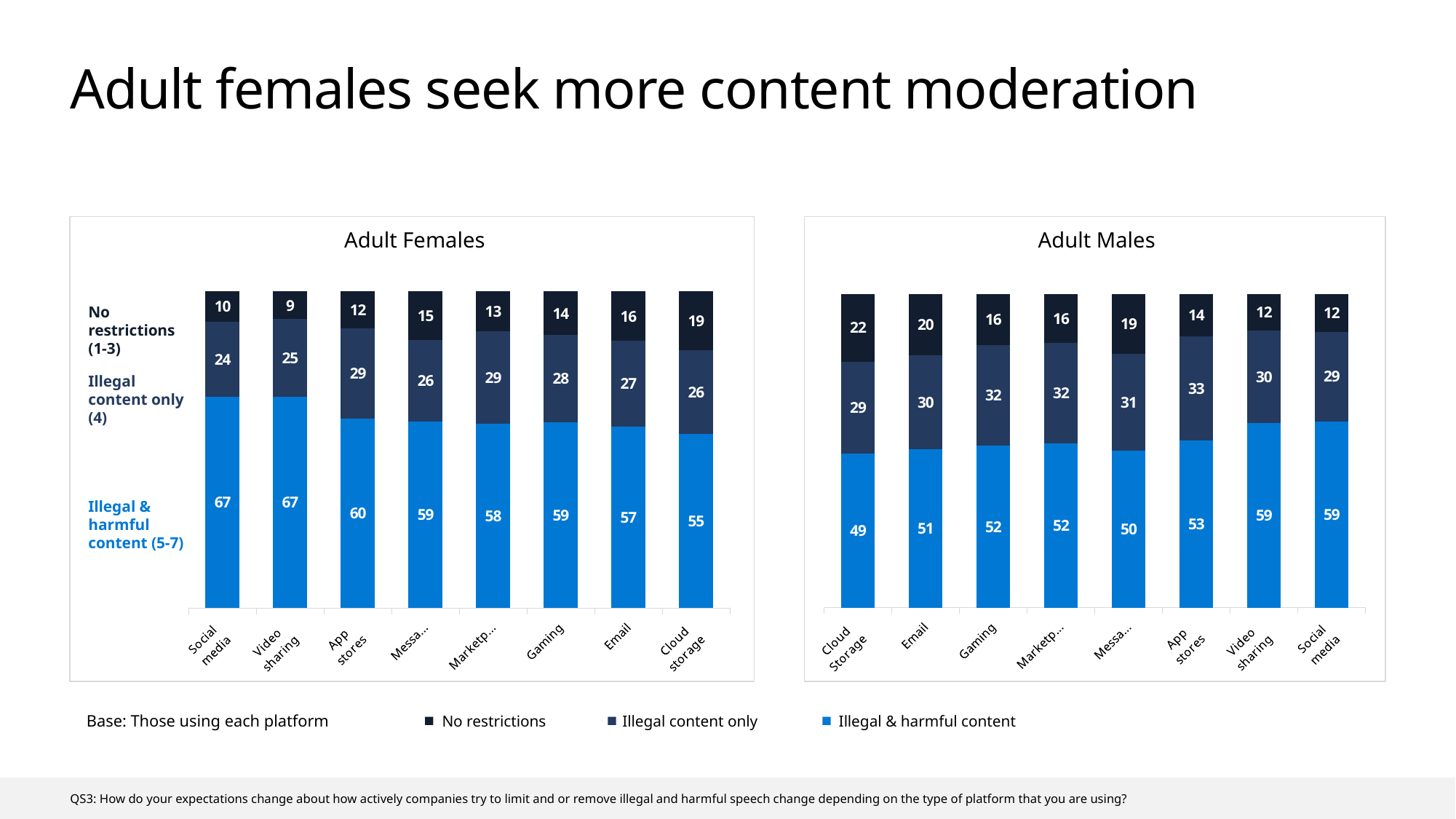
In the Adult Males chart, which category has the lowest value for Illegal & harmful content? Cloud Storage In the Adult Females chart, what is the difference between the Illegal & harmful content values for Social media and Cloud storage? 12 What kind of chart is the Adult Males chart? Stacked bar chart In the Adult Males chart, what is the value for Illegal content only for App stores? 33 How many series does the legend list? 3 In the Adult Females chart, which category has the highest value for No restrictions? Cloud storage Which is larger: the Illegal & harmful content value for Email in the Adult Females chart or in the Adult Males chart? Adult Females In the Adult Females chart, what is the value for Illegal & harmful content for Social media? 67 In the Adult Males chart, what is the value for No restrictions for Cloud Storage? 22 What is the title of the chart on the left? Adult Females How many categories are shown in the Adult Females chart? 8 In the Adult Males chart, what is the total of the stacked bar for Gaming? 100